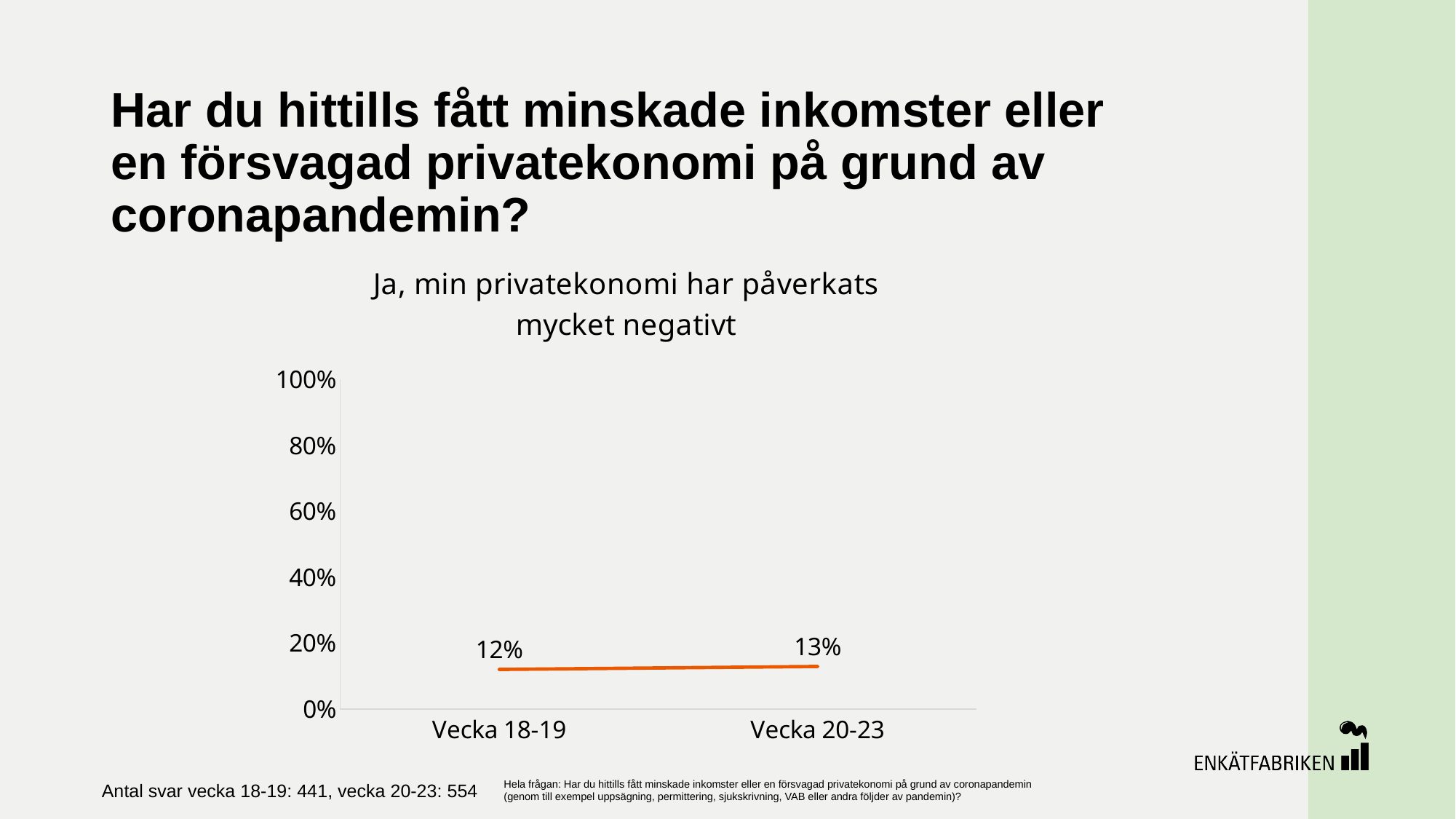
How many categories are shown on the x axis? 2 Is the value for Vecka 20-23 greater or less than 20%? less What is the highest value shown on the y axis? 100% What is the value for Vecka 18-19? 12% Do the values rise or fall from Vecka 18-19 to Vecka 20-23? rise What is the difference between the values for Vecka 20-23 and Vecka 18-19? 1% What is the title of the chart? Ja, min privatekonomi har påverkats mycket negativt Is the value for Vecka 18-19 greater or less than 40%? less What kind of chart is shown on the slide? line chart Which category has the lowest value? Vecka 18-19 Which category has the higher value, Vecka 18-19 or Vecka 20-23? Vecka 20-23 What is the value for Vecka 20-23? 13%